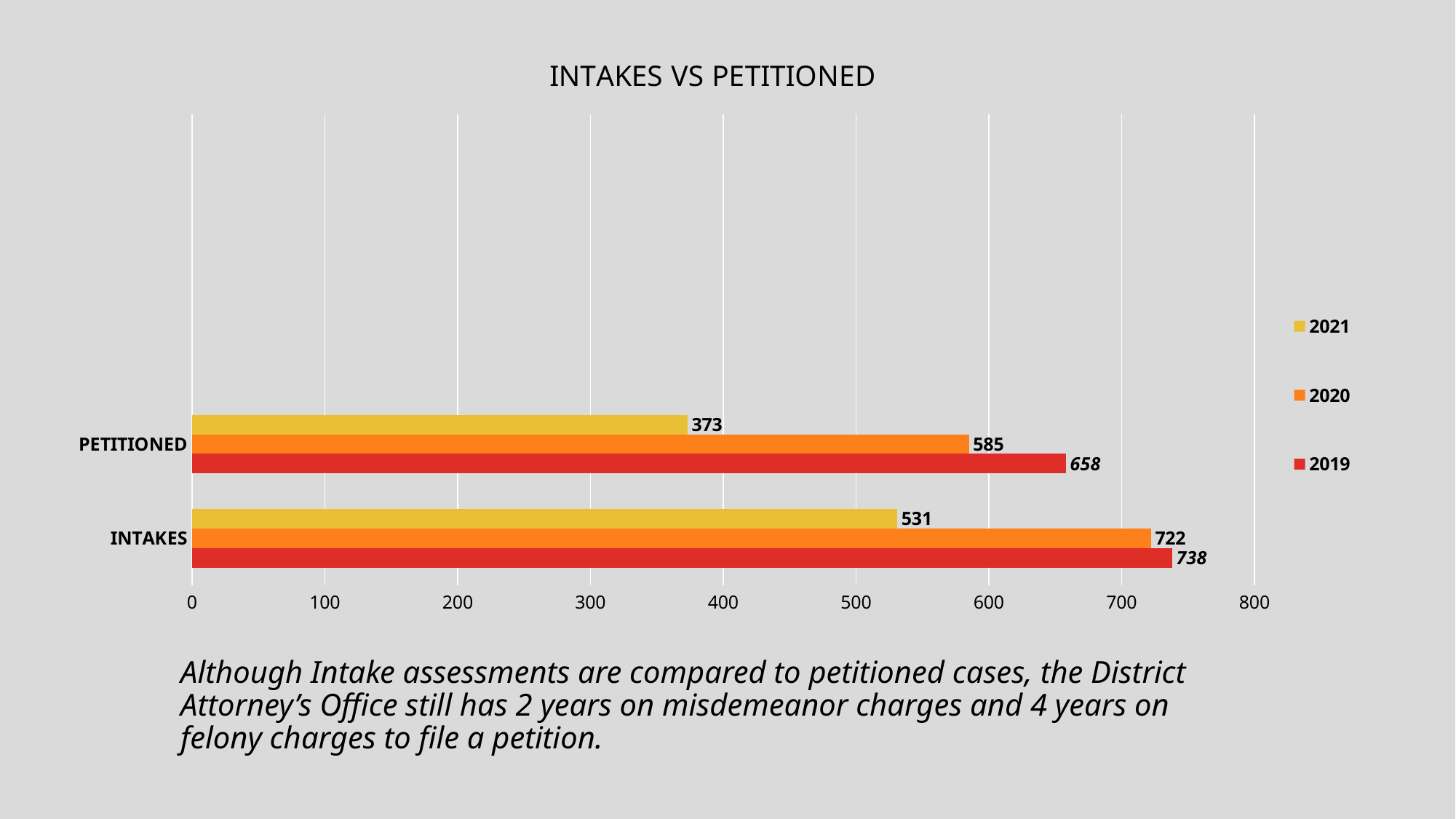
Which year has the highest value for INTAKES? 2019 Which year has the lowest value for PETITIONED? 2021 How many series does the legend list? 3 What is the value for PETITIONED in 2020? 585 What is the difference between INTAKES and PETITIONED in 2021? 158 Which is larger, PETITIONED in 2020 or INTAKES in 2021? PETITIONED in 2020 What is the title of the chart? INTAKES VS PETITIONED What kind of chart is shown on the slide? Bar chart What is the value for PETITIONED in 2019? 658 What is the value for INTAKES in 2019? 738 What is the value for INTAKES in 2021? 531 What is the difference between INTAKES and PETITIONED in 2020? 137